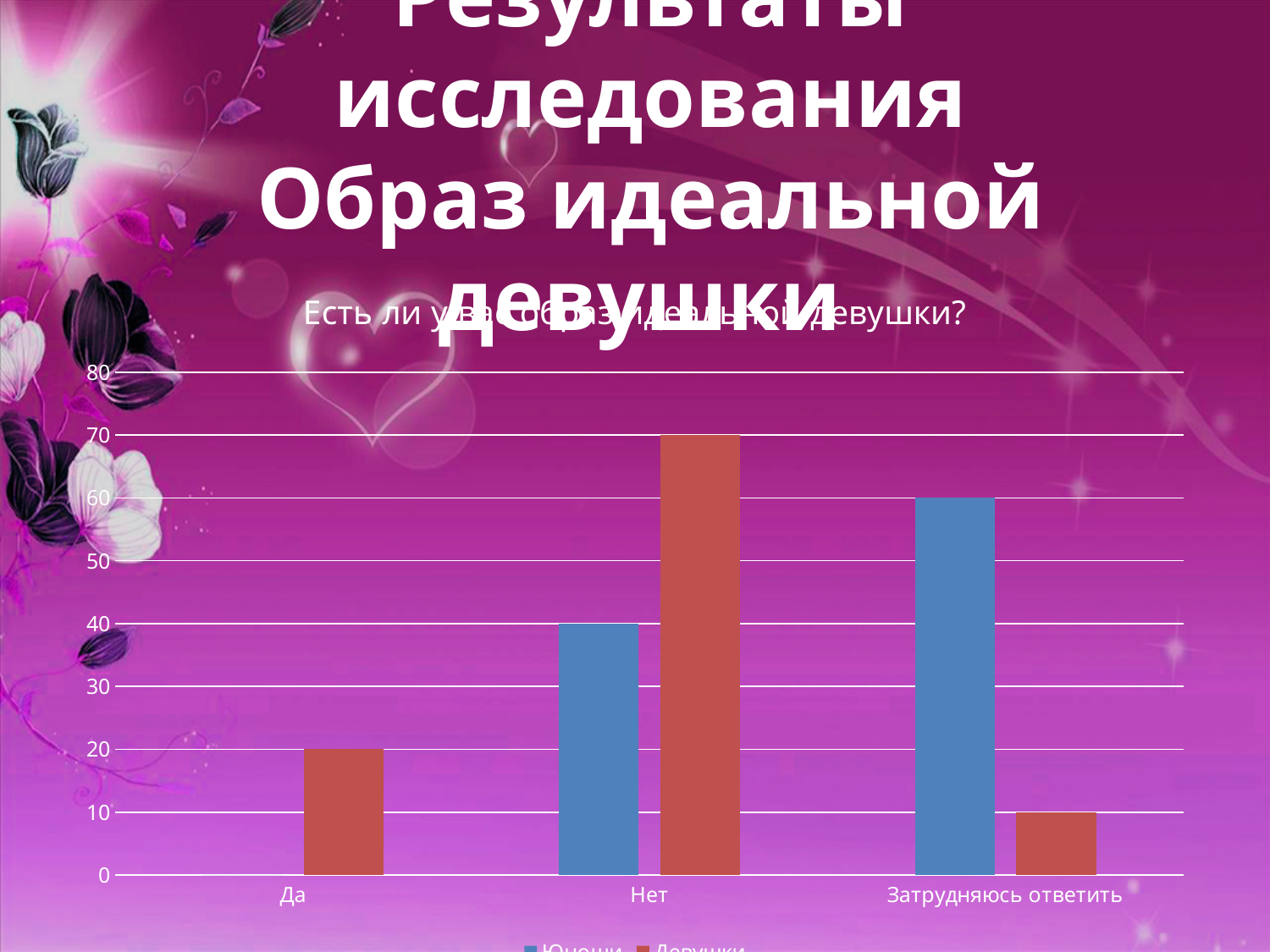
Which category has the highest red (Девушки) bar? Нет How many series does the chart's legend list? 2 What is the value of the blue (Юноши) bar for the category "Нет"? 40 What is the difference between the red (Девушки) and blue (Юноши) bars for the category "Нет"? 30 What is the value of the red (Девушки) bar for the category "Да"? 20 What kind of chart is shown on the slide? bar chart Which category has the lowest red (Девушки) bar? Затрудняюсь ответить What is the value of the red (Девушки) bar for "Затрудняюсь ответить"? 10 For "Затрудняюсь ответить", which bar is larger, the blue (Юноши) or the red (Девушки)? blue (Юноши) What is the value of the blue (Юноши) bar for "Затрудняюсь ответить"? 60 What is the value of the red (Девушки) bar for the category "Нет"? 70 How many categories are shown on the x axis of the chart? 3